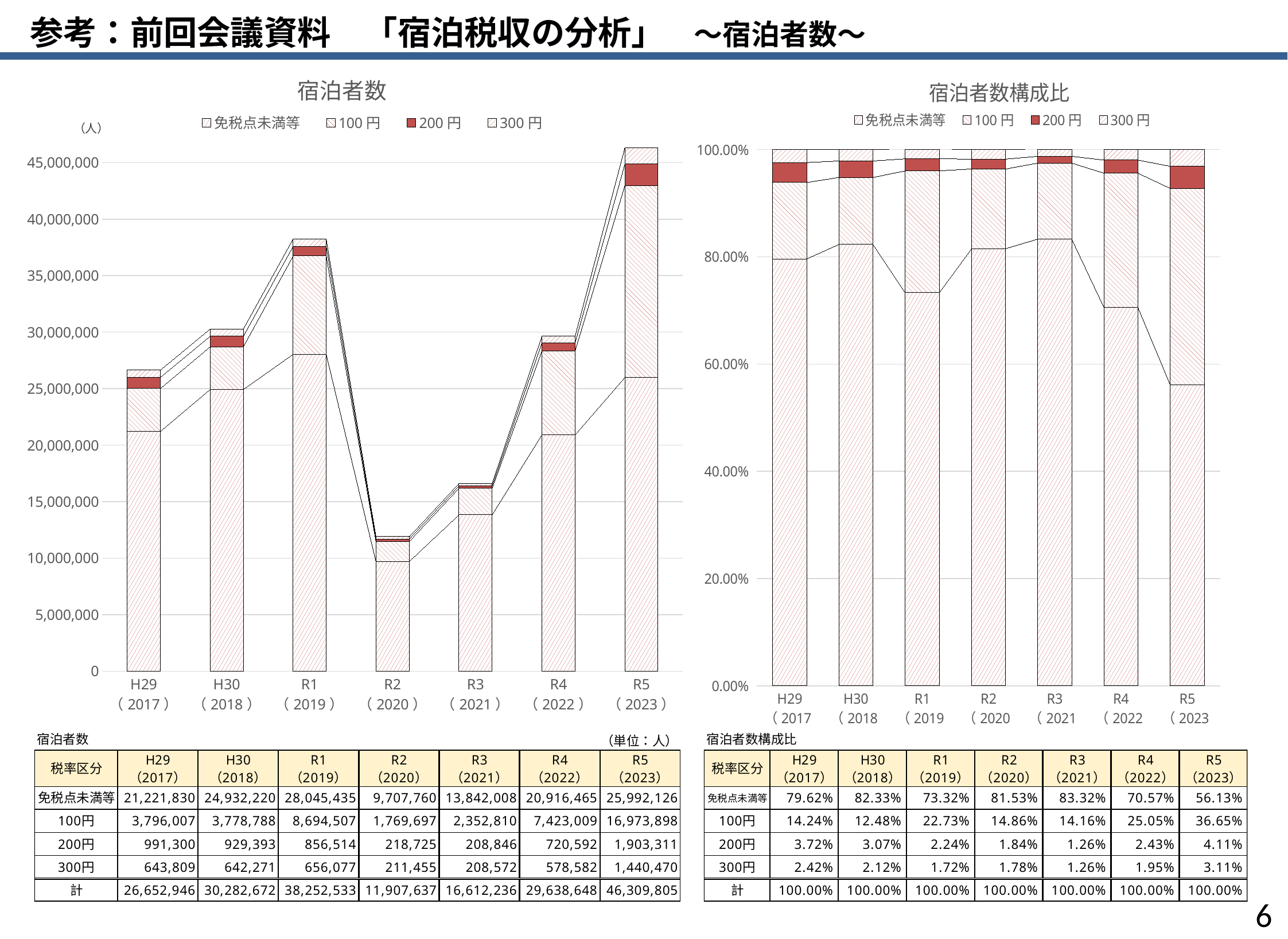
In the left chart 宿泊者数, what is the difference between the totals for R5 (2023) and R4 (2022)? 16,671,157 In the left chart 宿泊者数, what is the value of 免税点未満等 for R1 (2019)? 28,045,435 In the left chart 宿泊者数, is the 100円 value larger for R1 (2019) or R4 (2022)? R1 (2019) What kind of chart is the left chart titled 宿泊者数? bar chart In the left chart 宿泊者数, which year has the lowest total number of guests? R2 (2020) In the left chart 宿泊者数, what is the total (計) for R2 (2020)? 11,907,637 In the left chart 宿泊者数, how many fiscal years are shown on the x axis? 7 In the right chart 宿泊者数構成比, which year has the lowest share for 免税点未満等? R5 (2023) In the right chart 宿泊者数構成比, what share does 免税点未満等 have in R5 (2023)? 56.13% In the left chart 宿泊者数, is the total for R3 (2021) greater or less than 15,000,000? greater In the left chart 宿泊者数, which year has the highest total number of guests? R5 (2023) In the left chart 宿泊者数, how many series does the legend list? 4